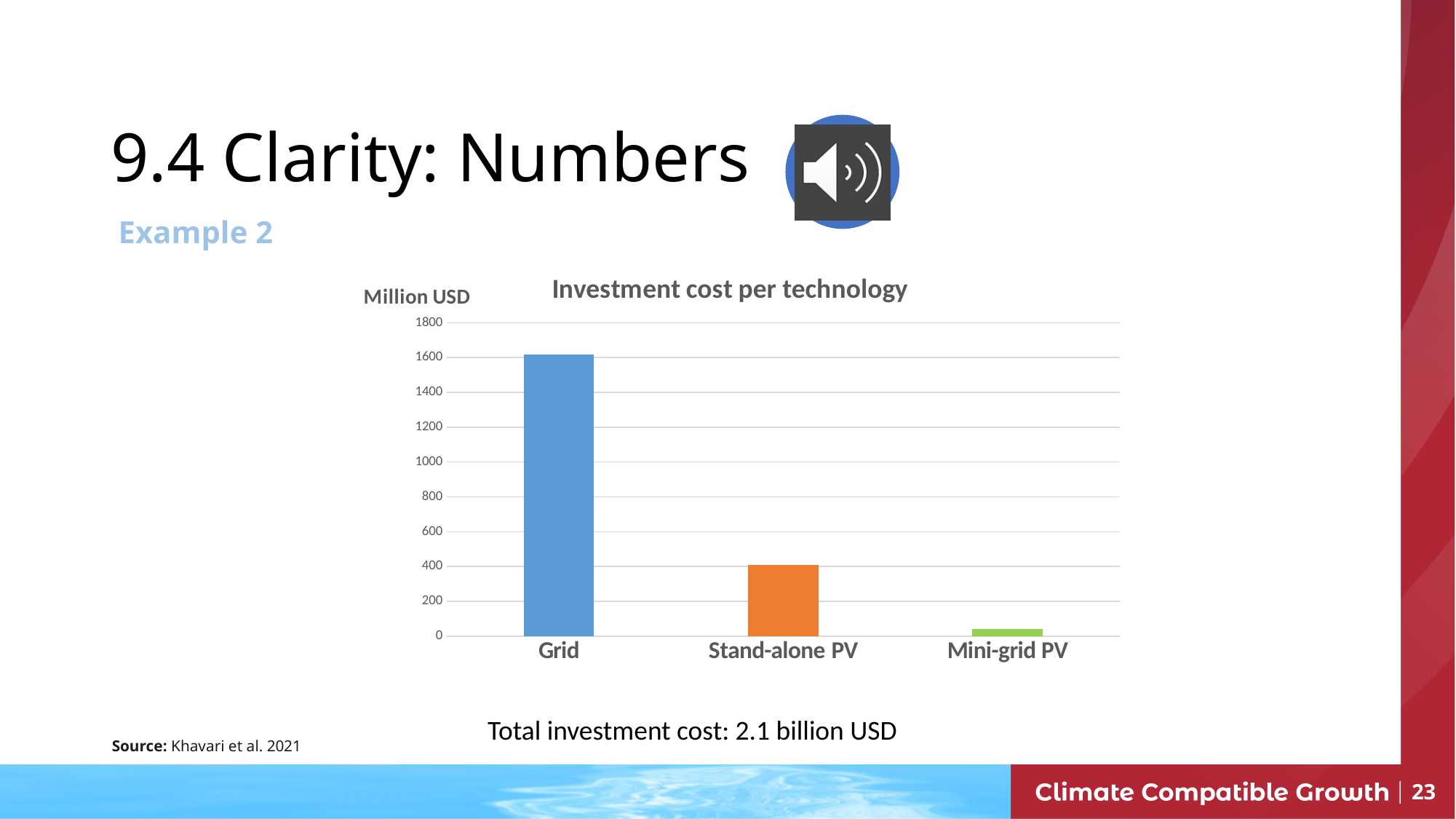
Which has a larger investment cost, Grid or Stand-alone PV? Grid How many technology categories are shown in the chart? 3 Is the investment cost for Stand-alone PV greater or less than 600 million USD? less What unit is shown on the vertical axis of the chart? Million USD Which technology has the lowest investment cost? Mini-grid PV What is the title of the chart? Investment cost per technology Which technology has the highest investment cost? Grid What type of chart is shown on the slide? bar chart Which has a larger investment cost, Stand-alone PV or Mini-grid PV? Stand-alone PV Is the investment cost for Grid greater or less than 1400 million USD? greater Do the investment costs rise or fall moving from Grid to Mini-grid PV along the x axis? fall Is the investment cost for Mini-grid PV greater or less than 200 million USD? less